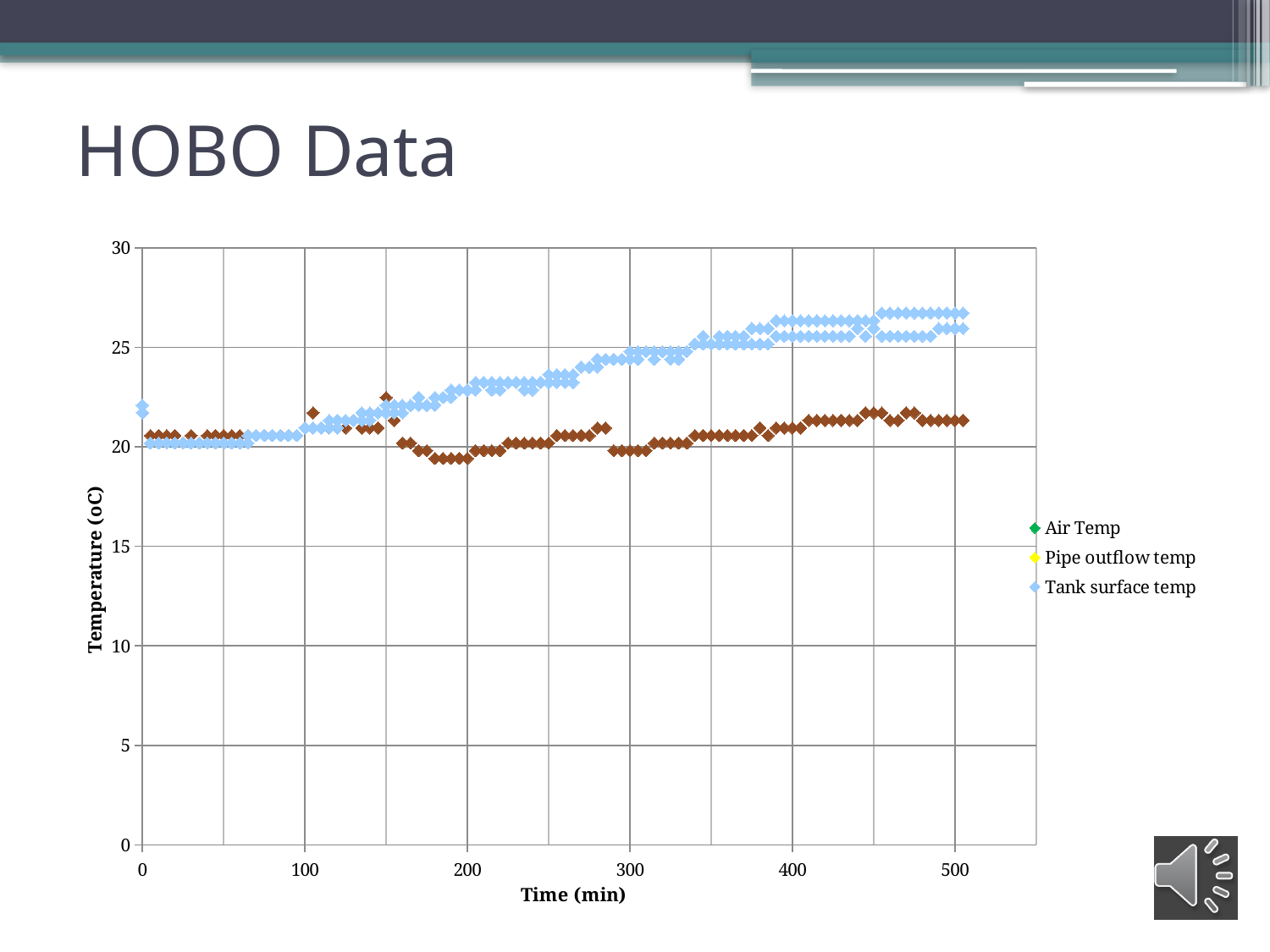
How many series does the legend list? 3 What kind of chart is shown on the slide? scatter chart Is the value of the brown series at 450 min greater or less than 25? less What is the highest value shown on the y axis? 30 Is the Tank surface temp value at 500 min greater or less than 25? greater What is the title of the y axis? Temperature (oC) At 400 min, which is higher: the Tank surface temp series or the brown series? Tank surface temp What is the title of the x axis? Time (min) Is the Tank surface temp value at 0 min greater or less than 25? less Does the Tank surface temp series rise or fall as time increases? rise